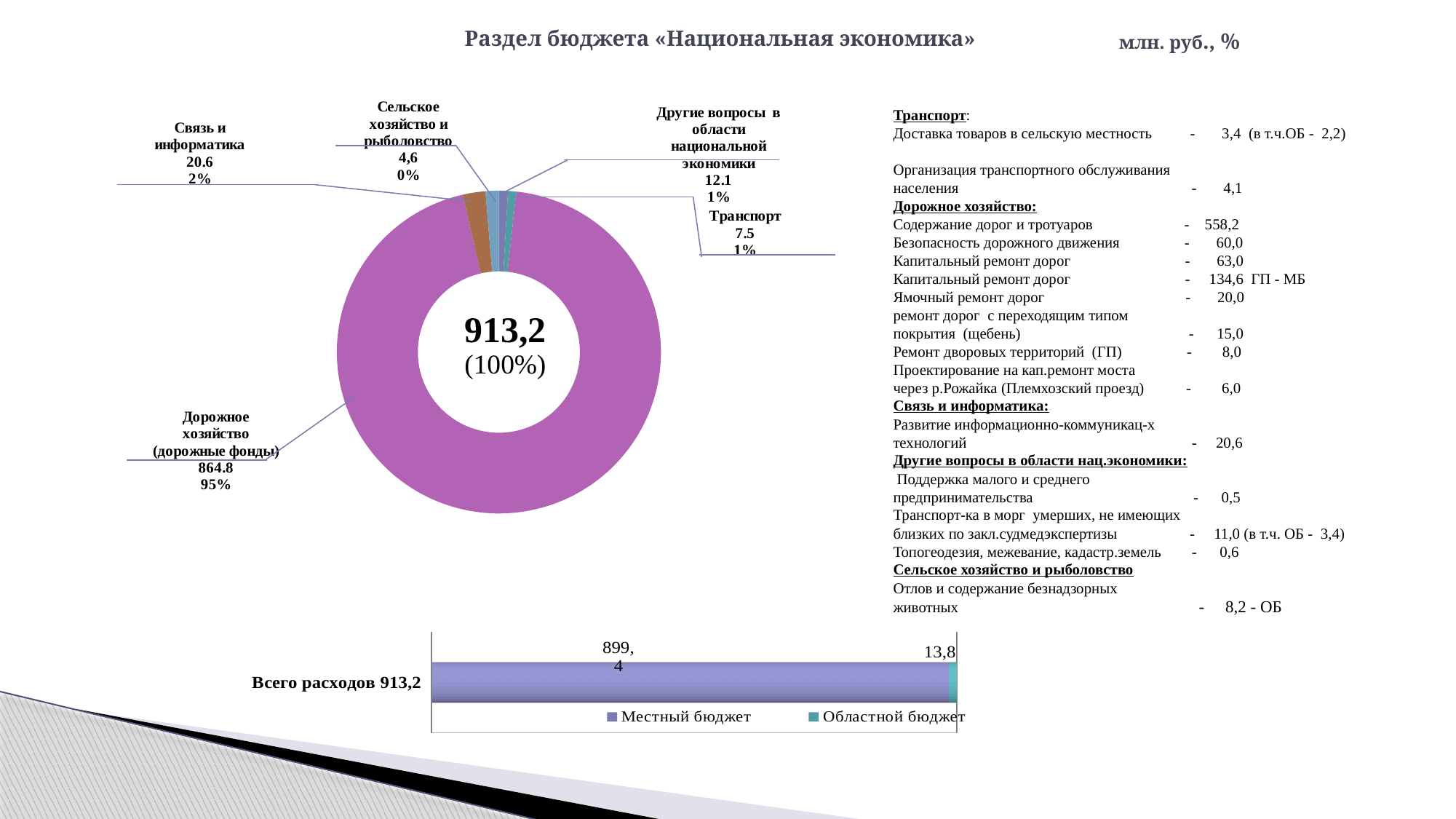
In the bar chart at the bottom, what value is shown for Областной бюджет? 13,8 In the doughnut chart, which is larger: Связь и информатика or Другие вопросы в области национальной экономики? Связь и информатика What total value is shown in the centre of the doughnut chart? 913,2 In the doughnut chart, what value is shown for Связь и информатика? 20.6 In the doughnut chart, what value is shown for Дорожное хозяйство (дорожные фонды)? 864.8 In the doughnut chart, what percentage share is shown for Сельское хозяйство и рыболовство? 0% In the doughnut chart, which category has the smallest value? Сельское хозяйство и рыболовство How many categories does the doughnut chart show? 5 In the doughnut chart, what percentage share is shown for Дорожное хозяйство (дорожные фонды)? 95% In the doughnut chart, which category has the largest value? Дорожное хозяйство (дорожные фонды) In the doughnut chart, what value is shown for Транспорт? 7.5 In the bar chart at the bottom, what value is shown for Местный бюджет? 899,4